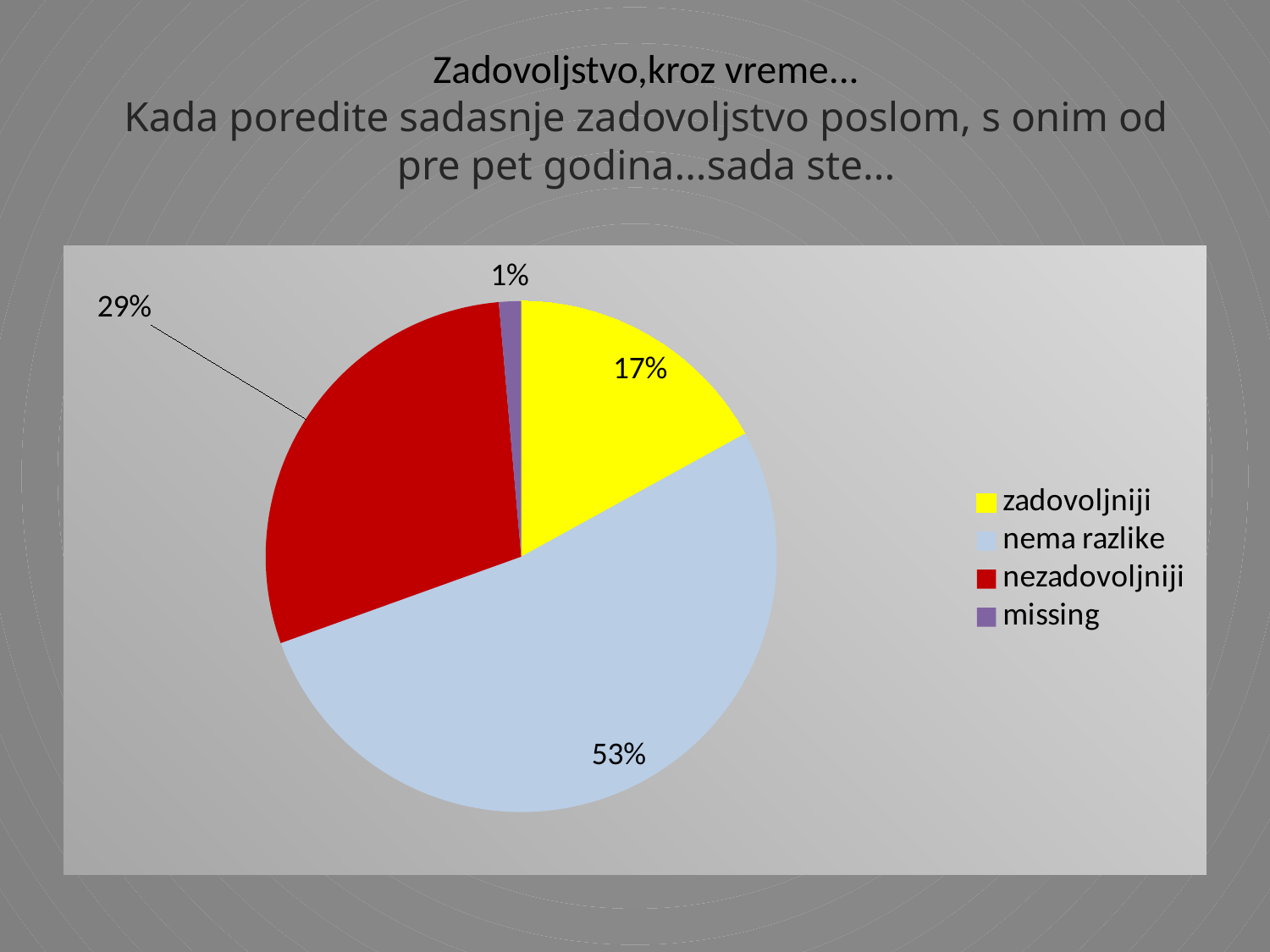
What share of the pie does "nezadovoljniji" represent? 29% What colour is the slice for "nezadovoljniji"? red What share of the pie does "missing" represent? 1% Which is larger, the slice for "zadovoljniji" or the slice for "nezadovoljniji"? nezadovoljniji What is the difference in percentage points between "nema razlike" and "nezadovoljniji"? 24 What share of the pie does "zadovoljniji" represent? 17% Which category has the largest slice of the pie? nema razlike How many categories does the legend list? 4 What is the difference in percentage points between "nezadovoljniji" and "zadovoljniji"? 12 Which category has the smallest slice of the pie? missing What kind of chart is shown on the slide? pie chart